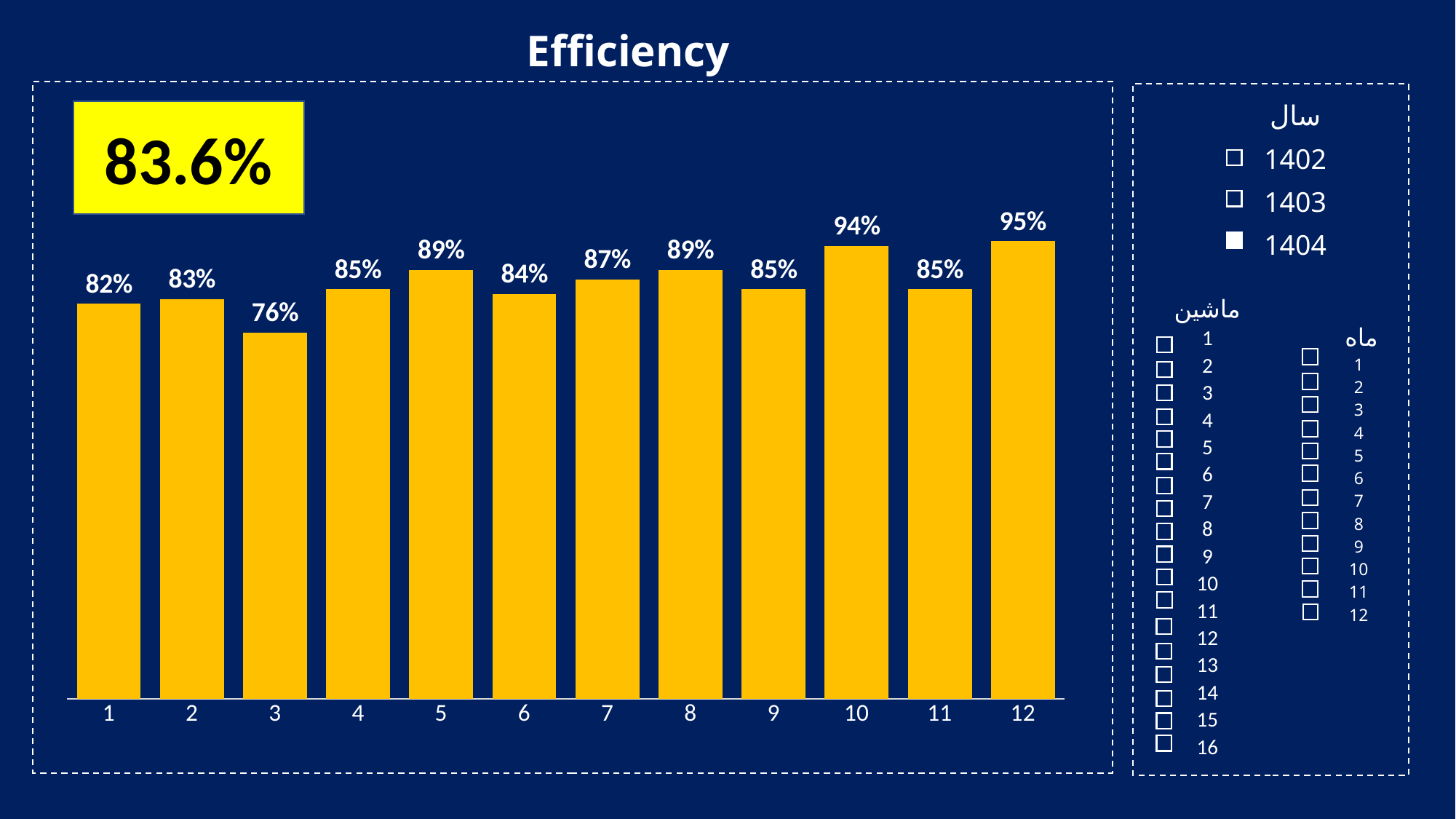
What is the title of the chart? Efficiency What is the efficiency value for category 10? 94% Which has a higher efficiency, category 5 or category 6? 5 What is the difference between the efficiency for category 10 and category 9? 9% What is the efficiency value for category 7? 87% Which category has the lowest efficiency? 3 Which category has the highest efficiency? 12 What kind of chart is shown on the slide? bar chart What is the difference between the efficiency for category 12 and category 3? 19% How many categories are shown on the x axis of the chart? 12 What value is shown in the yellow box at the top left of the chart? 83.6% What is the efficiency value for category 3? 76%